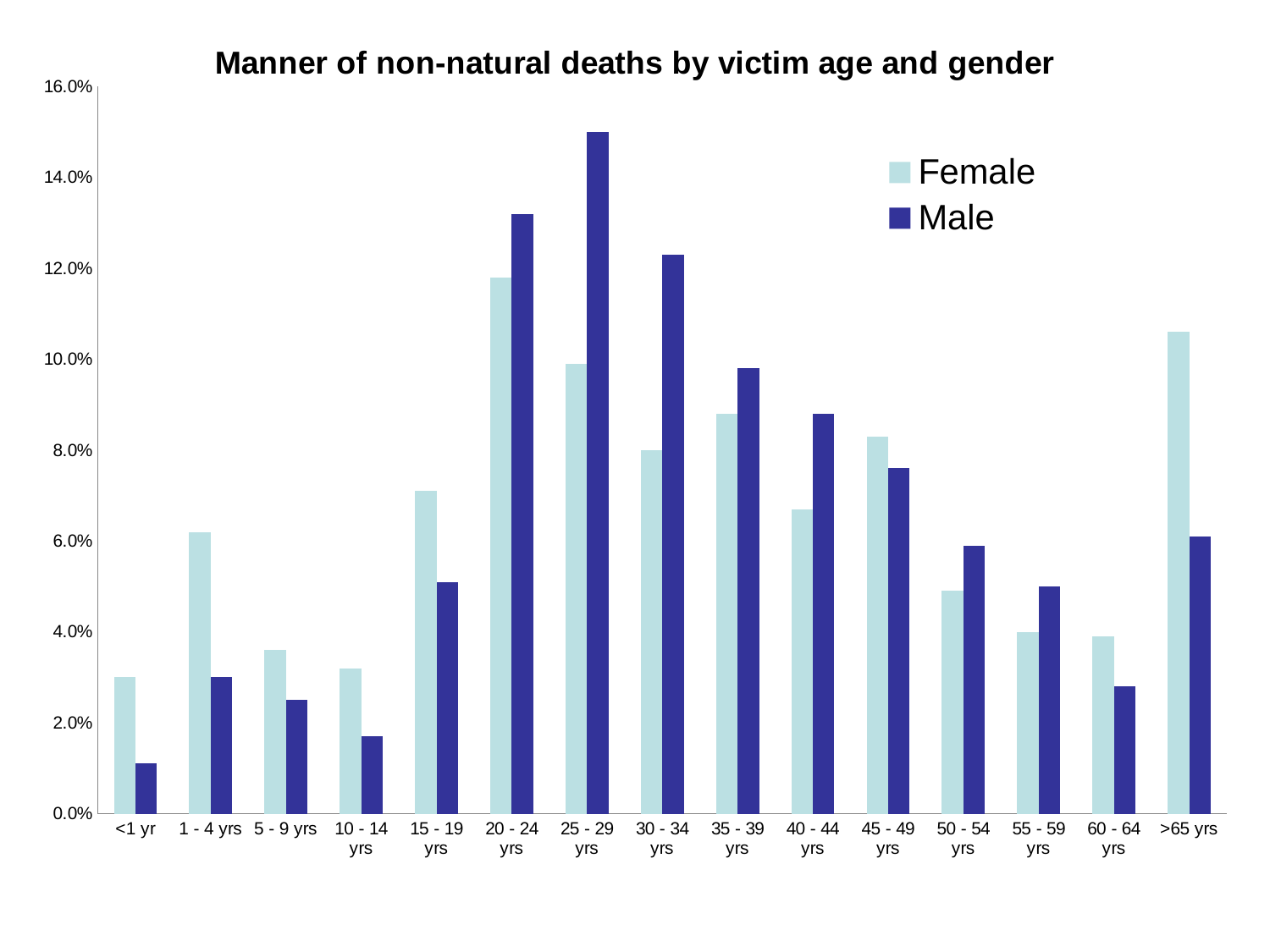
For >65 yrs, which is larger, the Female value or the Male value? Female Is the Male value for <1 yr greater or less than 2.0%? less Is the Male value for 25 - 29 yrs greater or less than 14.0%? greater Which age category has the highest Female value? 20 - 24 yrs How many age categories are shown on the x axis? 15 For 20 - 24 yrs, which is larger, the Female value or the Male value? Male Which age category has the lowest Male value? <1 yr Do the Male values rise or fall from 25 - 29 yrs to 60 - 64 yrs? fall What kind of chart is shown on the slide? bar chart Which age category has the highest Male value? 25 - 29 yrs How many series does the legend list? 2 Is the Female value for >65 yrs greater or less than 10.0%? greater